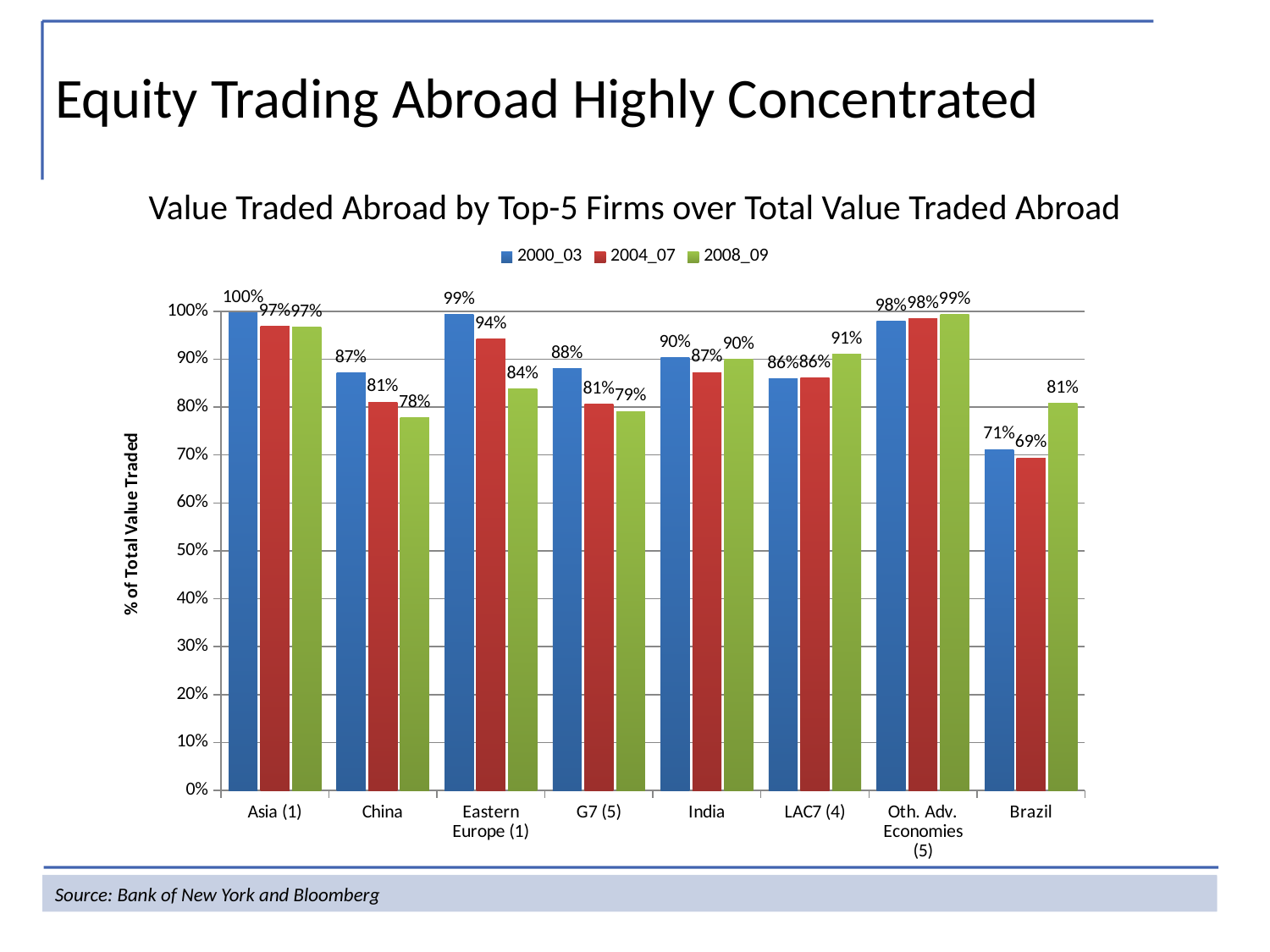
What is the title of the chart? Value Traded Abroad by Top-5 Firms over Total Value Traded Abroad What is the value for Eastern Europe (1) in the 2004_07 series? 94% Which category has the lowest value in the 2004_07 series? Brazil Which is larger for India: the 2000_03 value or the 2004_07 value? 2000_03 How many series does the legend list? 3 What is the value for China in the 2000_03 series? 87% What kind of chart is shown on the slide? Bar chart Which category has the highest value in the 2000_03 series? Asia (1) Do the values for China fall or rise from the 2000_03 series to the 2008_09 series? Fall What is the value for Brazil in the 2008_09 series? 81% How many categories are shown on the x axis? 8 What is the difference between the 2000_03 and 2008_09 values for Eastern Europe (1)? 15%